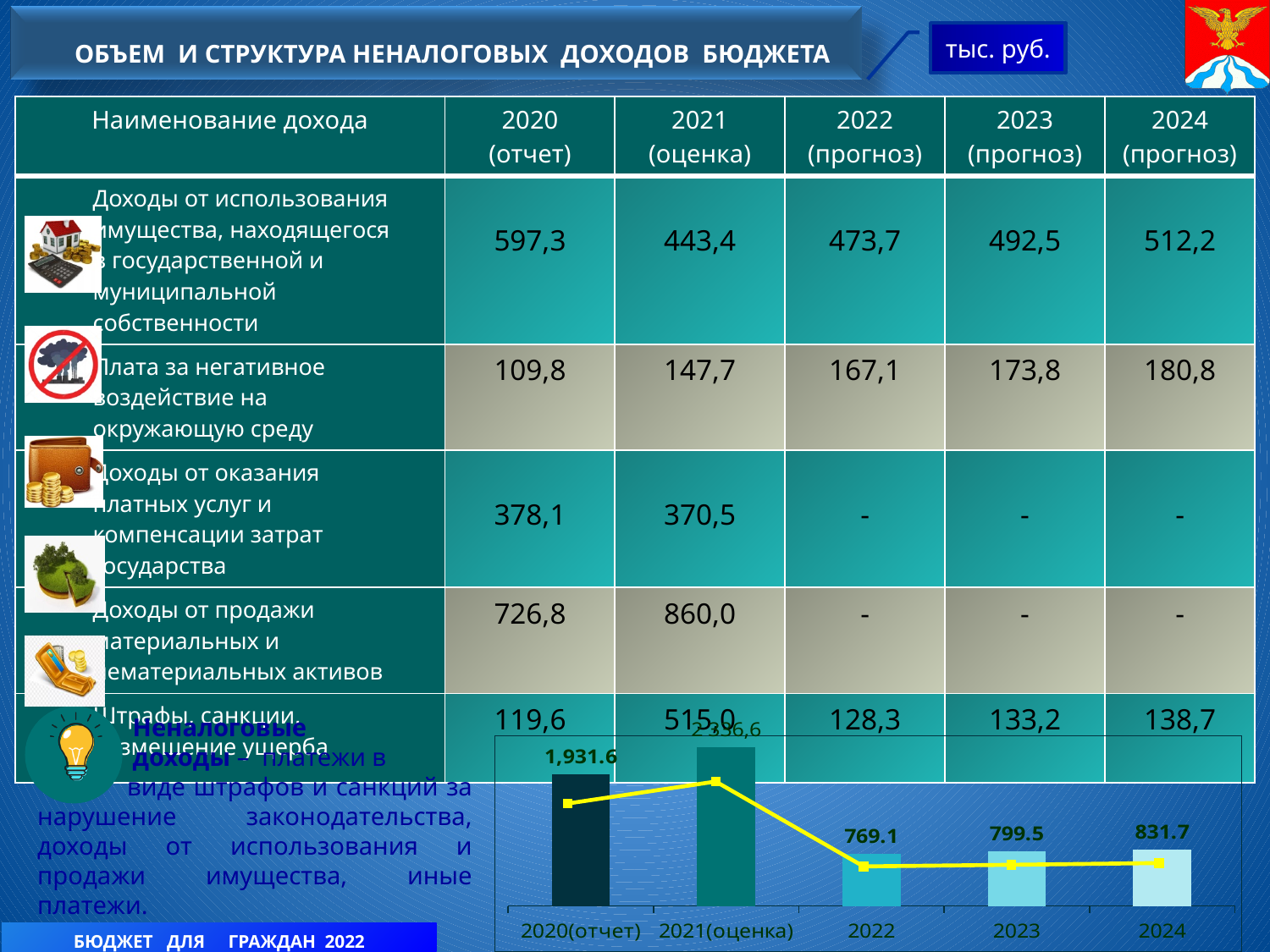
What colour is the line drawn over the bars in the chart at the bottom of the slide? yellow In the chart at the bottom of the slide, do the values rise or fall from 2022 to 2024? rise In the chart at the bottom of the slide, which is larger, the value for 2023 or the value for 2024? 2024 In the chart at the bottom of the slide, what is the value for 2024? 831.7 In the chart at the bottom of the slide, what is the value for 2023? 799.5 In the chart at the bottom of the slide, what is the value for 2020(отчет)? 1,931.6 How many categories are plotted on the x axis of the chart at the bottom of the slide? 5 In the chart at the bottom of the slide, what is the value for 2022? 769.1 In the chart at the bottom of the slide, which category has the highest value? 2021(оценка) In the chart at the bottom of the slide, which category has the lowest value? 2022 In the chart at the bottom of the slide, what is the difference between the values for 2024 and 2022? 62.6 What kind of chart is shown at the bottom of the slide? bar chart